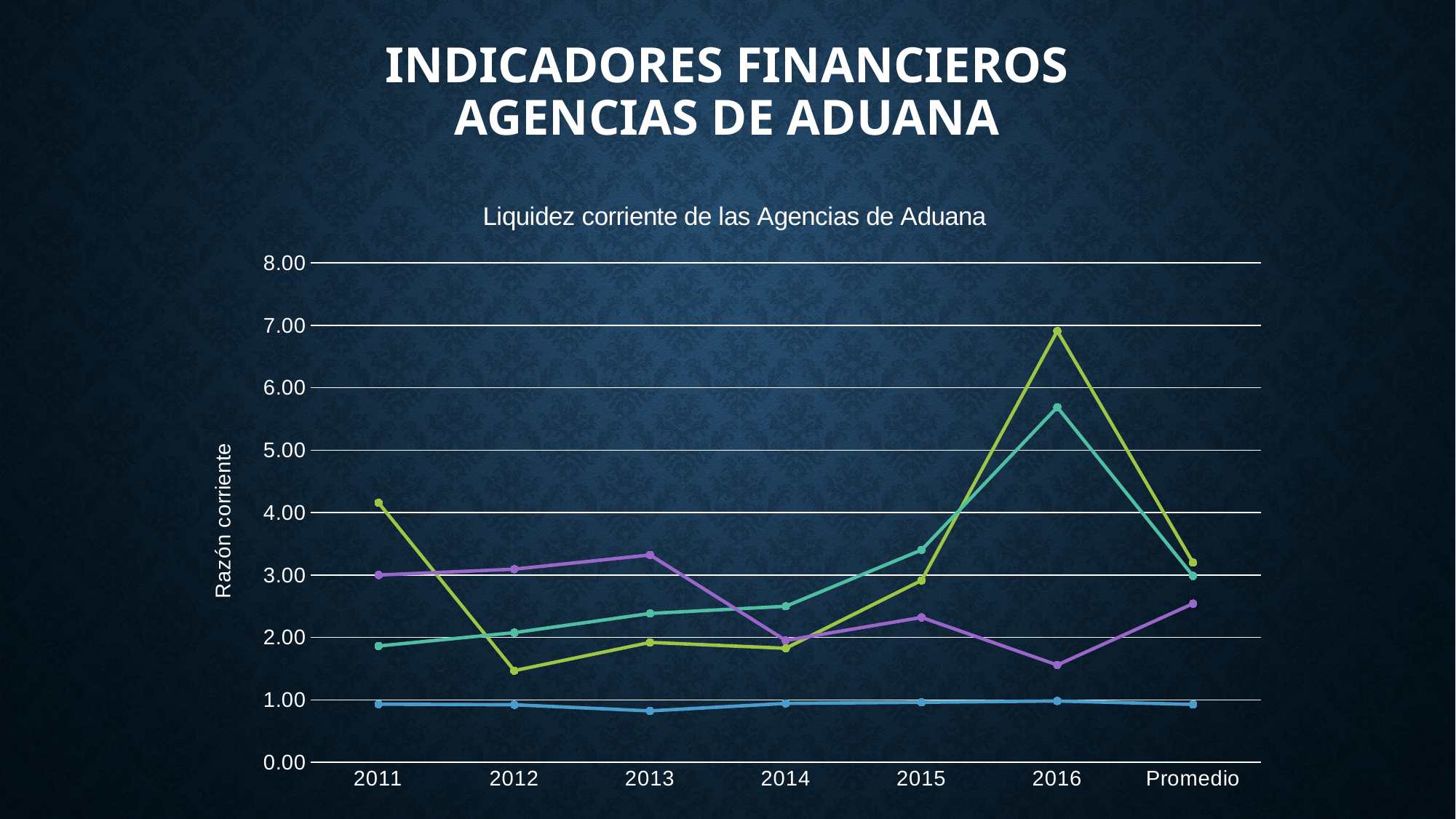
Is the value of the teal line for 2016 greater or less than 5.00? greater Is the value of the blue line for 2013 greater or less than 1.00? less At 2016, which line has the larger value, the green line or the teal line? green line Is the value of the green line for 2011 greater or less than 3.00? greater What kind of chart is shown on the slide? line chart What is the title of the chart? Liquidez corriente de las Agencias de Aduana How many categories are shown along the x axis of the chart? 7 In which category does the green line reach its highest value? 2016 In which category does the purple line reach its lowest value? 2016 What is the label on the vertical axis of the chart? Razón corriente